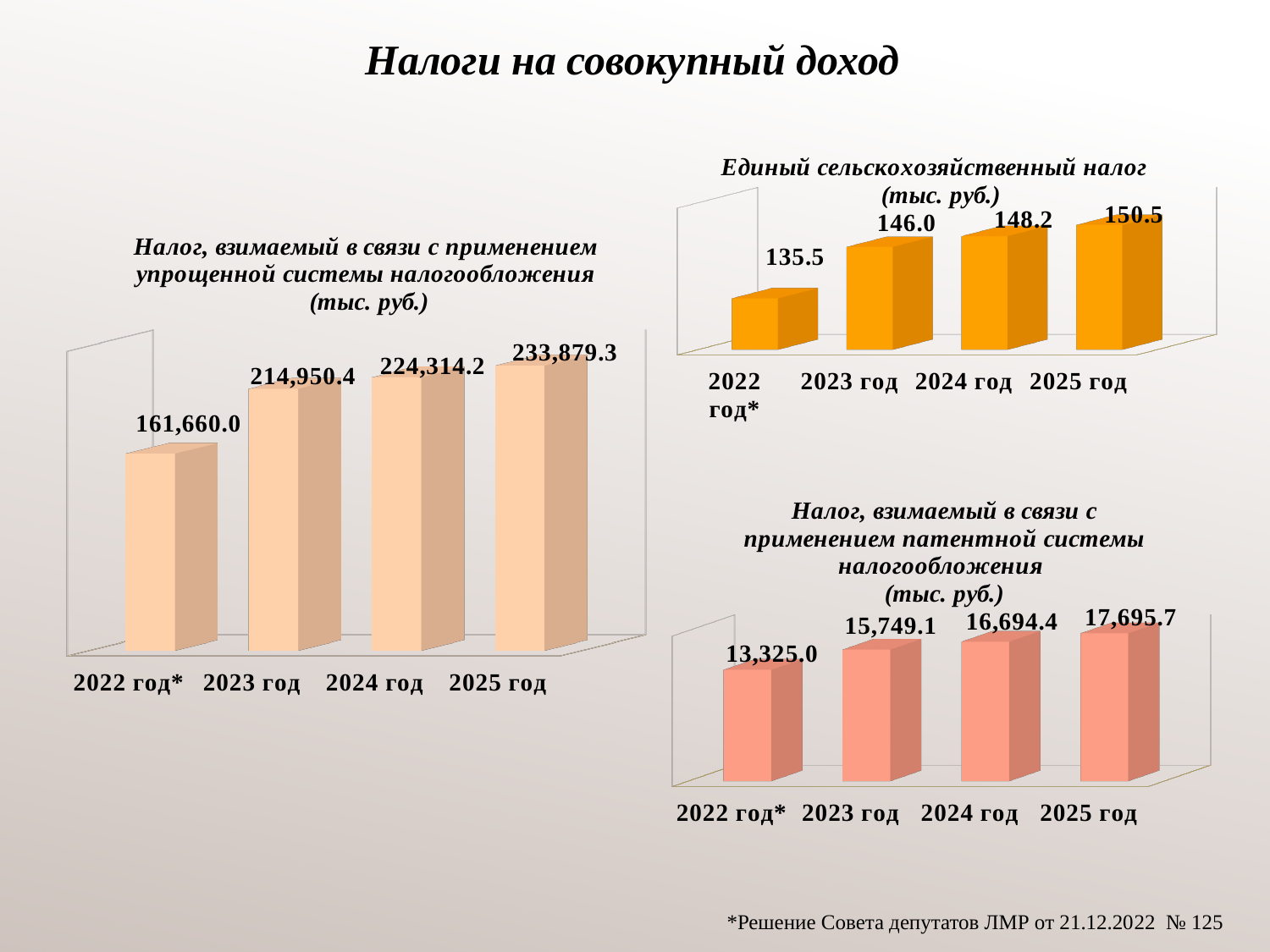
In the chart 'Единый сельскохозяйственный налог', what is the value for 2023 год? 146.0 In the chart 'Единый сельскохозяйственный налог', which year has the highest value? 2025 год In the chart 'Единый сельскохозяйственный налог', what is the difference between the values for 2025 год and 2022 год*? 15.0 In the chart 'Налог, взимаемый в связи с применением упрощенной системы налогообложения', what is the value for 2022 год*? 161,660.0 In the chart 'Налог, взимаемый в связи с применением патентной системы налогообложения', which year has the lowest value? 2022 год* In the chart 'Налог, взимаемый в связи с применением упрощенной системы налогообложения', what is the difference between the values for 2025 год and 2022 год*? 72,219.3 How many years (categories) are shown in the chart 'Единый сельскохозяйственный налог'? 4 What type of chart is the chart 'Налог, взимаемый в связи с применением патентной системы налогообложения'? Bar chart In the chart 'Налог, взимаемый в связи с применением патентной системы налогообложения', what is the value for 2025 год? 17,695.7 In the chart 'Налог, взимаемый в связи с применением патентной системы налогообложения', what is the difference between the values for 2024 год and 2023 год? 945.3 In the chart 'Налог, взимаемый в связи с применением упрощенной системы налогообложения', do the values rise or fall from 2022 год* to 2025 год? Rise In the chart 'Налог, взимаемый в связи с применением упрощенной системы налогообложения', which is larger: the value for 2023 год or 2024 год? 2024 год